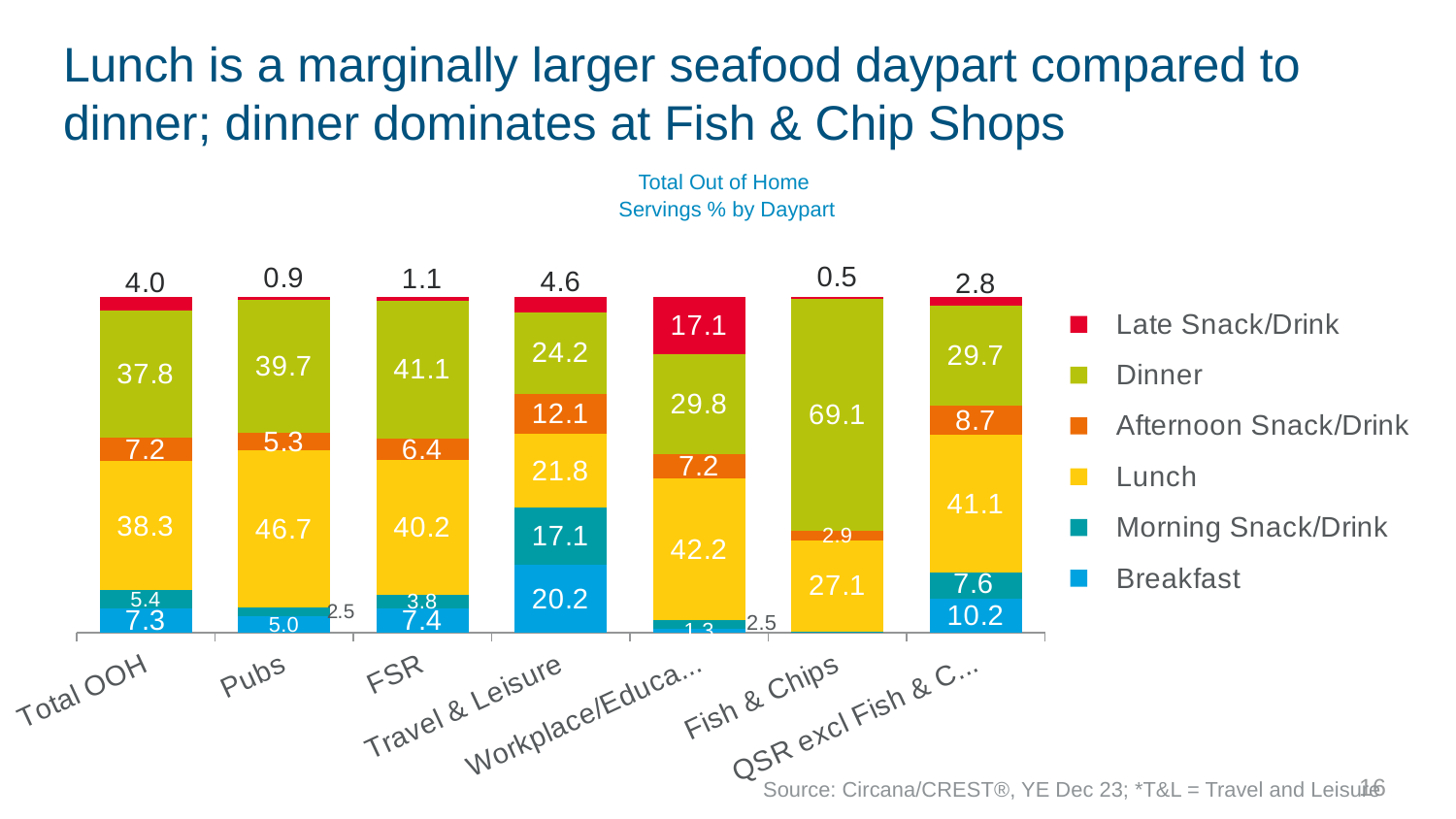
What is the Lunch value for Pubs? 46.7 What is the Breakfast value for Travel & Leisure? 20.2 How many categories are shown on the x axis? 7 What is the Afternoon Snack/Drink value for QSR excl Fish & C...? 8.7 What is the difference between the Lunch and Dinner values for Total OOH? 0.5 For FSR, which is larger: the Dinner value or the Lunch value? Dinner Which category has the highest Late Snack/Drink value? Workplace/Educa... How many series does the legend list? 6 What is the title of the chart? Total Out of Home Servings % by Daypart What kind of chart is shown on the slide? Stacked bar chart What is the Dinner value for Fish & Chips? 69.1 Which category has the highest Dinner value? Fish & Chips